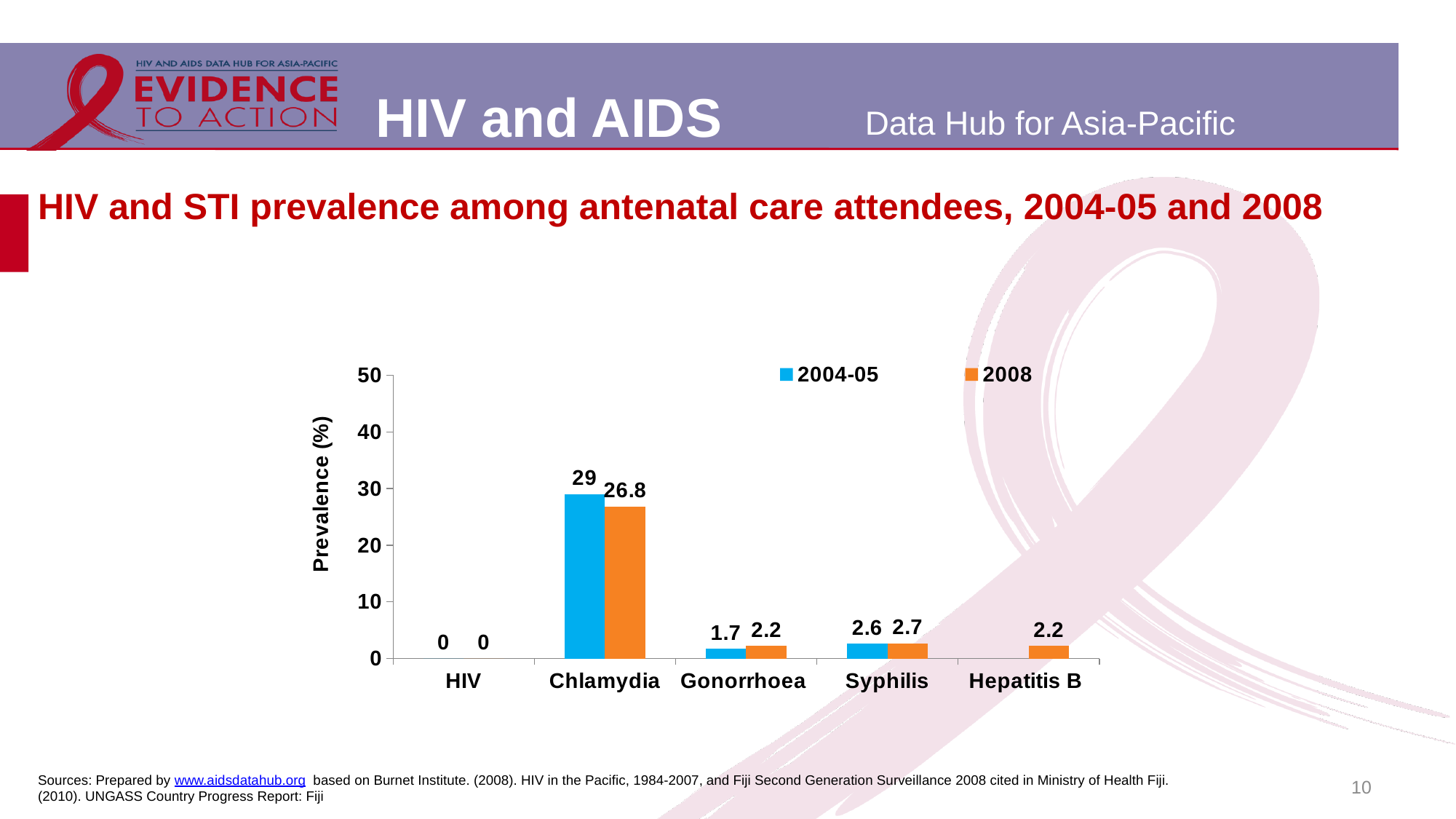
Which category has the lowest prevalence in 2008? HIV What is the difference between the Chlamydia prevalence in 2004-05 and in 2008? 2.2 What kind of chart is shown on the slide? Bar chart How many categories are shown on the x axis? 5 How many series does the legend list? 2 What is the prevalence of Hepatitis B in 2008? 2.2 What is the prevalence of Gonorrhoea in 2008? 2.2 Which is larger, the Gonorrhoea prevalence in 2004-05 or in 2008? 2008 Which category has the highest prevalence in 2004-05? Chlamydia What is the prevalence of Chlamydia in 2004-05? 29 What is the prevalence of Syphilis in 2004-05? 2.6 What is the prevalence of Chlamydia in 2008? 26.8